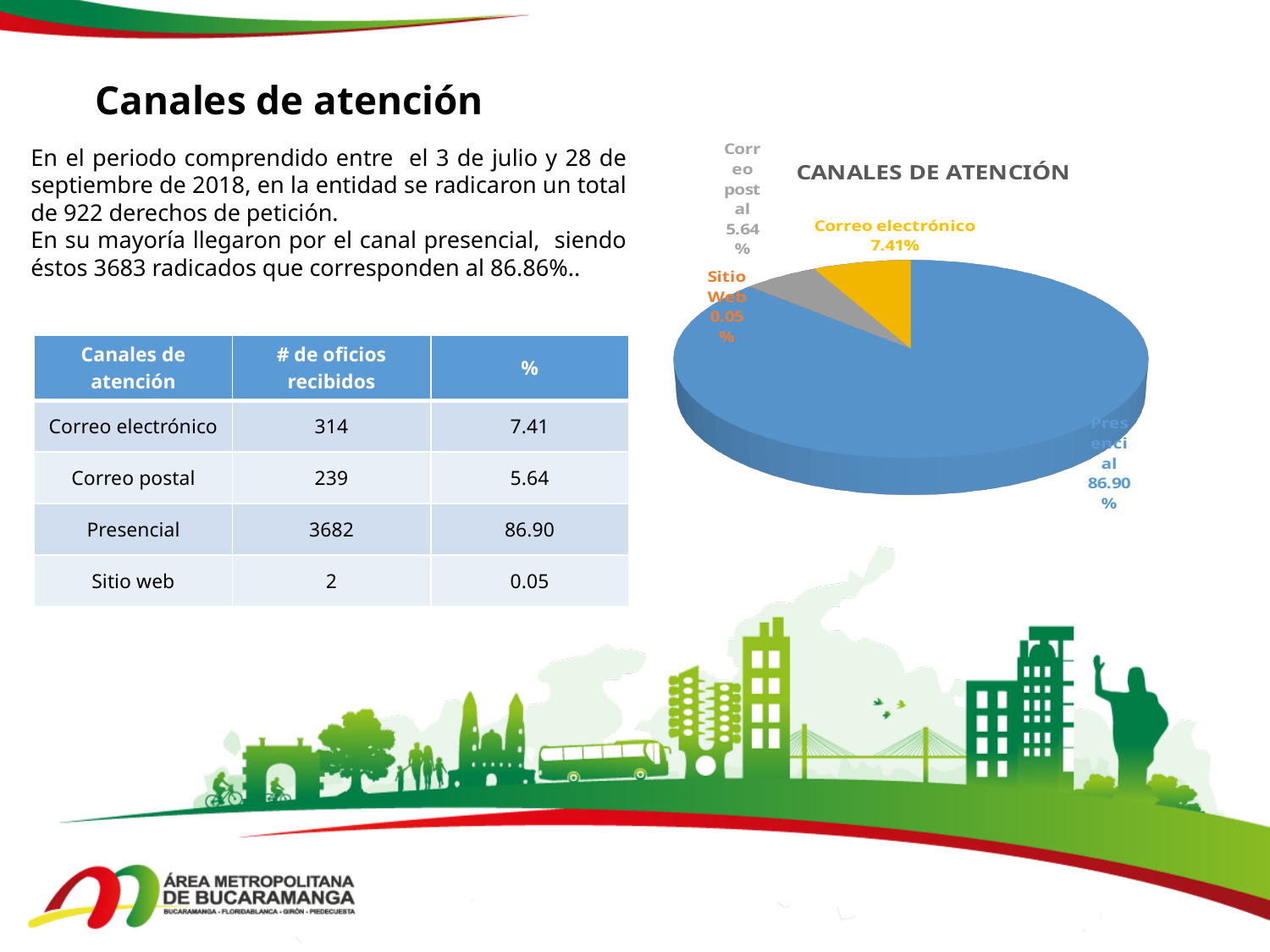
What is the title of the chart? CANALES DE ATENCIÓN Which category has the smallest slice of the pie? Sitio Web What is the difference in percentage points between the Correo electrónico slice and the Correo postal slice? 1.77 What percentage does the Presencial slice show? 86.90% How many slices does the pie chart have? 4 What kind of chart is shown on the slide? pie chart What percentage does the Correo postal slice show? 5.64% Which category has the largest slice of the pie? Presencial What colour is the Presencial slice? blue What percentage does the Sitio Web slice show? 0.05% Which is larger, the Correo electrónico slice or the Correo postal slice? Correo electrónico What percentage does the Correo electrónico slice show? 7.41%